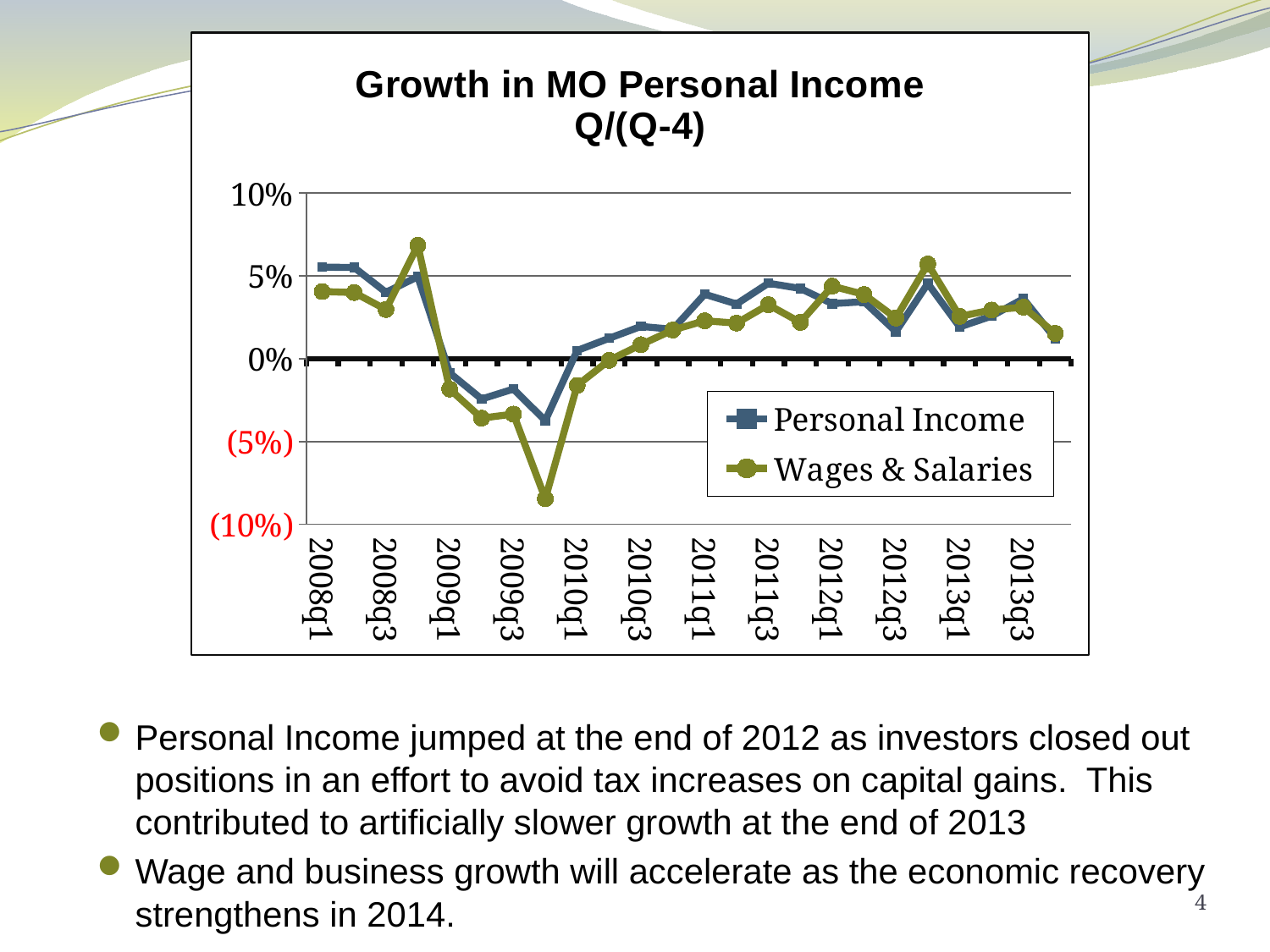
At 2008q1, which series has the higher value, Personal Income or Wages & Salaries? Personal Income What is the title of the chart? Growth in MO Personal Income Q/(Q-4) What kind of chart is shown on the slide? Line chart Is the lowest value reached by the Wages & Salaries series greater or less than (5%)? less Is the value for Personal Income at 2011q1 greater or less than 0%? greater Does the Personal Income series rise or fall from 2008q1 to 2009q3? Fall Which two series are listed in the legend? Personal Income and Wages & Salaries How many quarter labels are shown on the x axis? 12 Is the value for Wages & Salaries at 2008q1 greater or less than 5%? less Which series reaches the lowest value on the chart? Wages & Salaries How many series does the legend list? 2